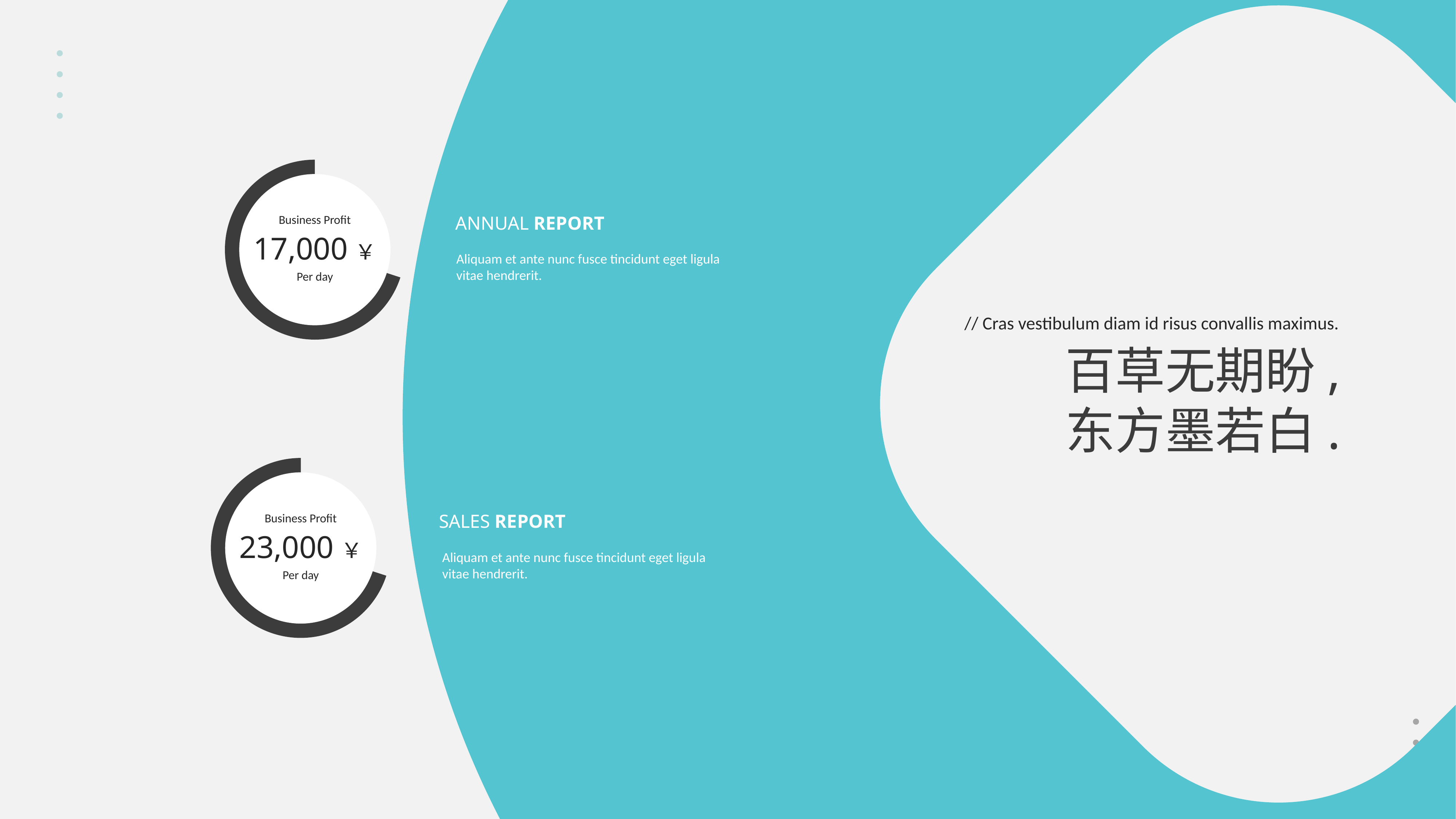
What is the difference between the business profit in the lower ring chart (23,000 ¥) and the upper ring chart (17,000 ¥)? 6,000 ¥ What time period is stated below the value in each ring chart? Per day What value is shown in the lower ring chart next to SALES REPORT? 23,000 ¥ Which ring chart shows the larger business profit, the upper one (ANNUAL REPORT) or the lower one (SALES REPORT)? the lower one (SALES REPORT) How many ring charts are shown on the slide? 2 What label appears above the value in each ring chart? Business Profit What kind of chart is used to display the business profit figures on the slide? ring (doughnut) chart Is the value in the lower ring chart (SALES REPORT) greater or less than 20,000 ¥? greater Is the value in the upper ring chart (ANNUAL REPORT) greater or less than 20,000 ¥? less What value is shown in the upper ring chart next to ANNUAL REPORT? 17,000 ¥